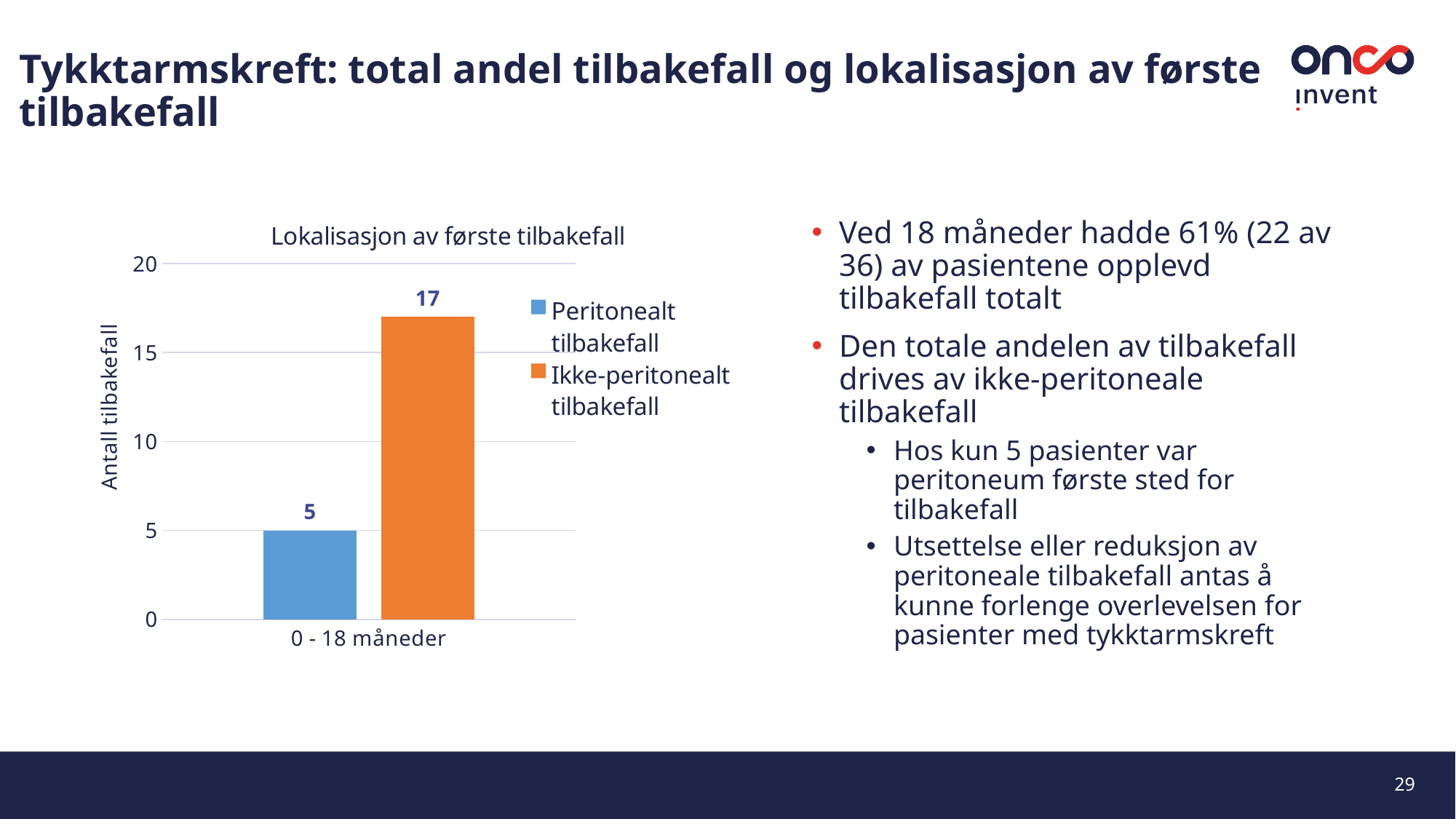
What is the value for Peritonealt tilbakefall in the chart? 5 Which series has the lower value in the chart? Peritonealt tilbakefall Which series has the higher value in the chart? Ikke-peritonealt tilbakefall Is the value for Peritonealt tilbakefall greater or less than 10? less What is the label on the vertical axis of the chart? Antall tilbakefall What is the sum of the two bar values in the chart? 22 What kind of chart is shown on the slide? Bar chart What is the title of the chart? Lokalisasjon av første tilbakefall How many series does the legend list? 2 What is the difference between the Ikke-peritonealt tilbakefall and Peritonealt tilbakefall values? 12 Is the value for Ikke-peritonealt tilbakefall greater or less than 15? greater What is the value for Ikke-peritonealt tilbakefall in the chart? 17